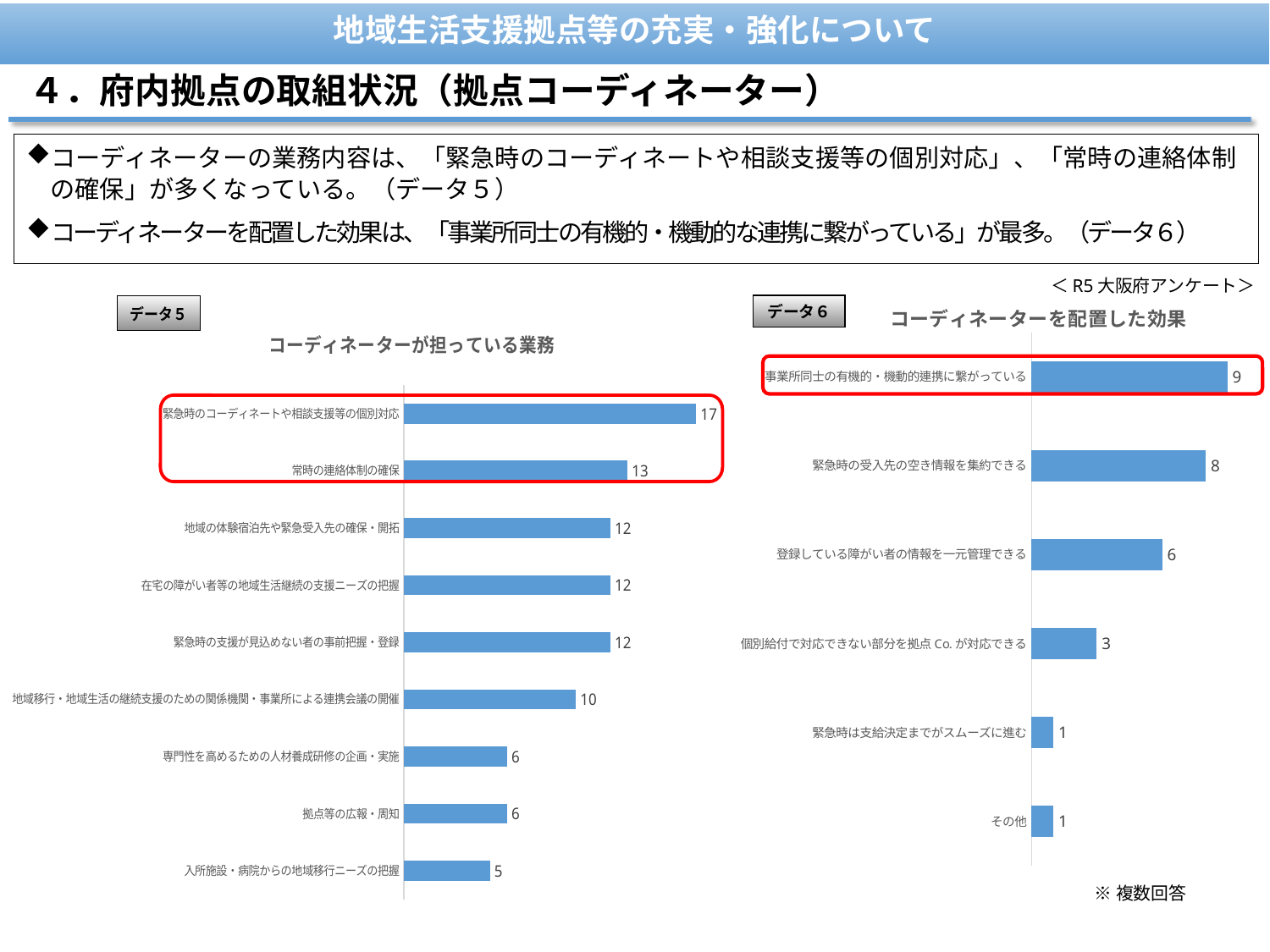
In the chart titled コーディネーターを配置した効果, what is the value for 個別給付で対応できない部分を拠点Co.が対応できる? 3 In the chart titled コーディネーターを配置した効果, how many categories are plotted? 6 In the chart titled コーディネーターが担っている業務, which category has the lowest value? 入所施設・病院からの地域移行ニーズの把握 In the chart titled コーディネーターが担っている業務, what is the value for 地域移行・地域生活の継続支援のための関係機関・事業所による連携会議の開催? 10 In the chart titled コーディネーターが担っている業務, what is the value for 緊急時のコーディネートや相談支援等の個別対応? 17 In the chart titled コーディネーターが担っている業務, what is the difference between 緊急時のコーディネートや相談支援等の個別対応 and 常時の連絡体制の確保? 4 In the chart titled コーディネーターを配置した効果, which is larger: 登録している障がい者の情報を一元管理できる or 緊急時は支給決定までがスムーズに進む? 登録している障がい者の情報を一元管理できる What kind of chart is the chart titled コーディネーターを配置した効果? Bar chart In the chart titled コーディネーターが担っている業務, how many categories are plotted? 9 In the chart titled コーディネーターを配置した効果, what is the value for 緊急時の受入先の空き情報を集約できる? 8 In the chart titled コーディネーターが担っている業務, what is the value for 常時の連絡体制の確保? 13 In the chart titled コーディネーターを配置した効果, which category has the highest value? 事業所同士の有機的・機動的連携に繋がっている